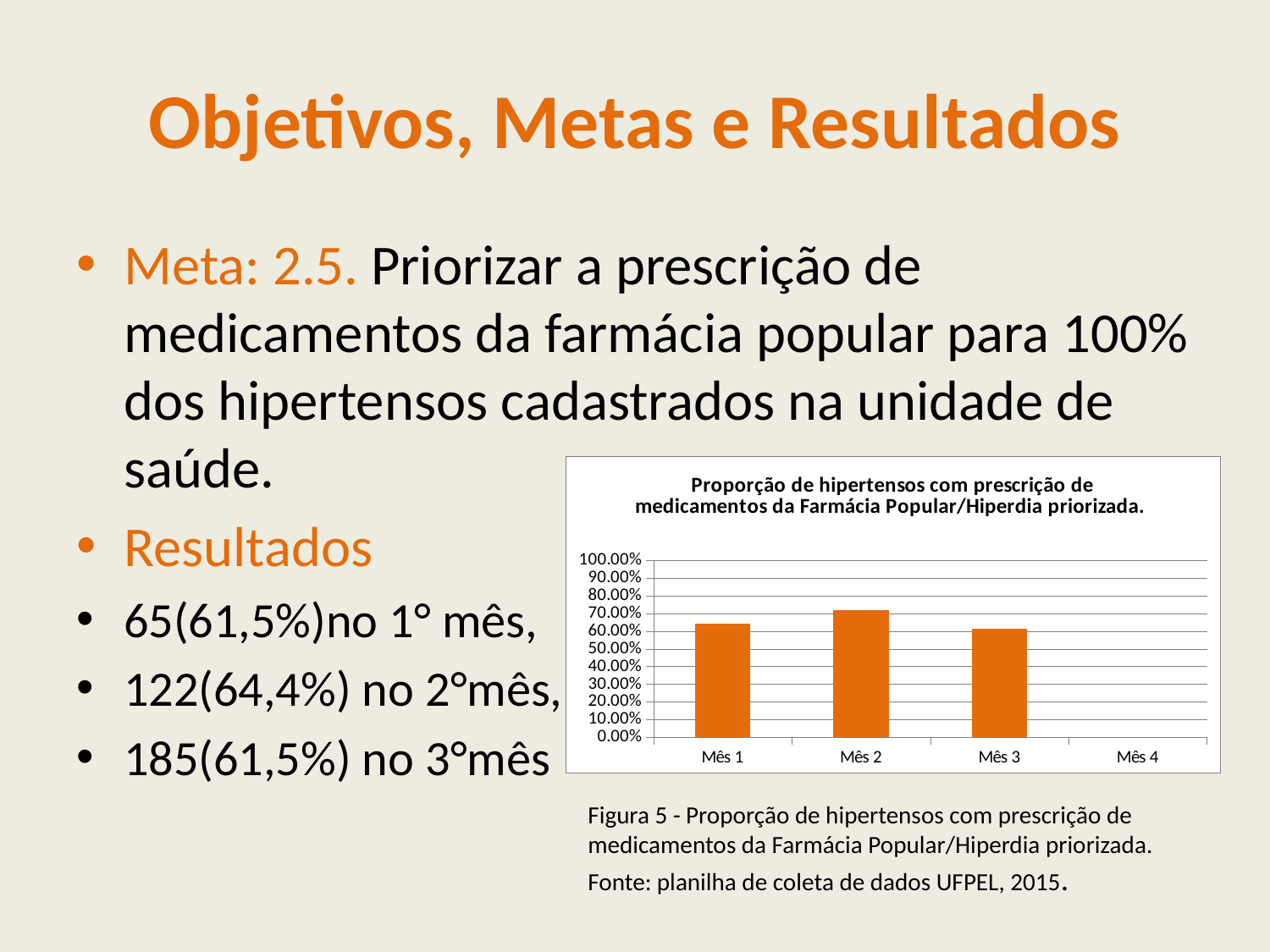
What is the title of the chart? Proporção de hipertensos com prescrição de medicamentos da Farmácia Popular/Hiperdia priorizada. Is the value for Mês 1 greater or less than 70.00%? less Which month has the highest bar in the chart? Mês 2 Which is larger, the value for Mês 2 or the value for Mês 3? Mês 2 Is the value for Mês 1 greater or less than 50.00%? greater Which month on the x axis has no bar plotted? Mês 4 Is the value for Mês 3 greater or less than 50.00%? greater What is the highest value shown on the y axis of the chart? 100.00% What kind of chart is shown on the slide? bar chart How many categories are shown on the x axis of the chart? 4